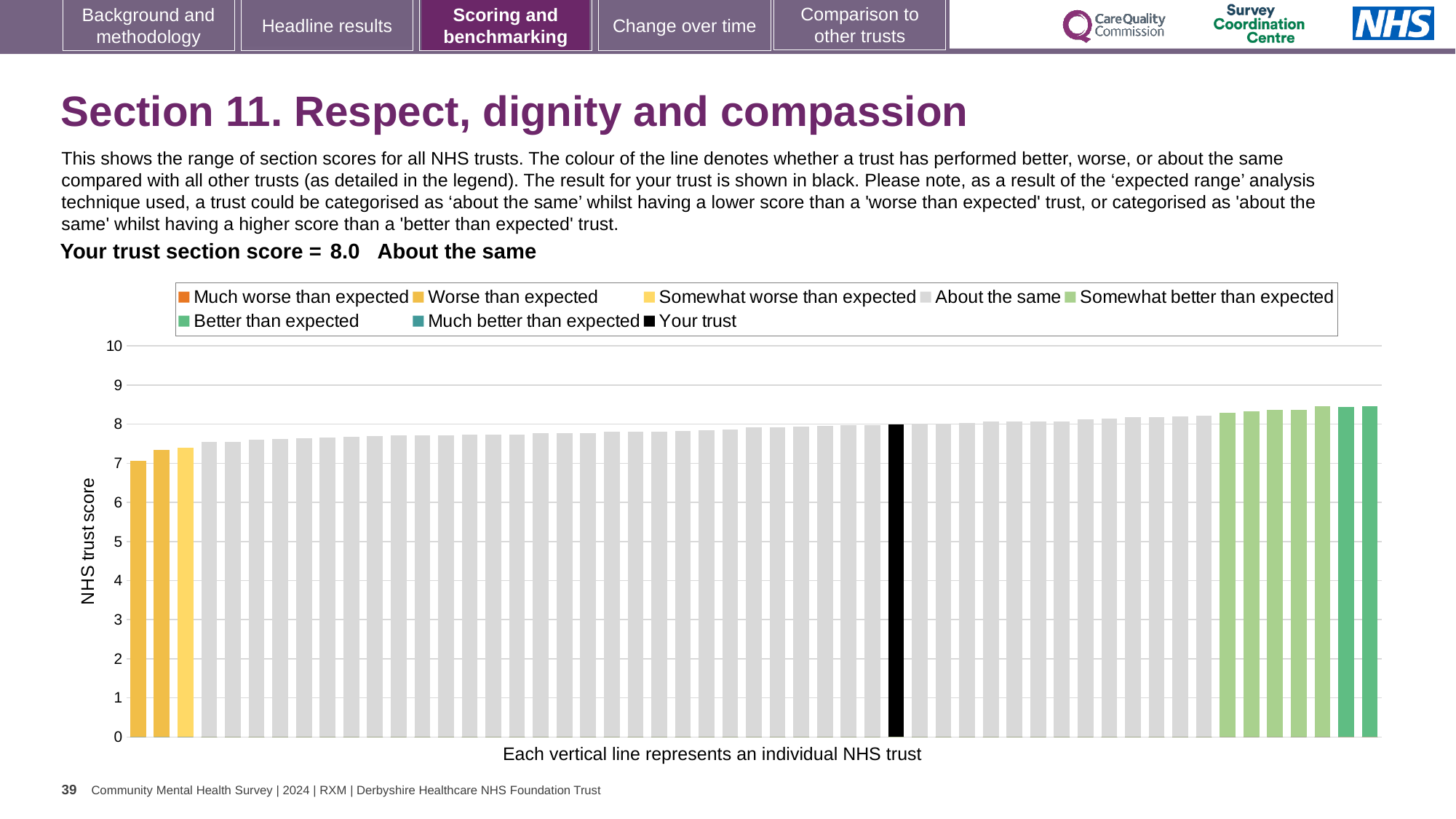
What colour is the bar representing your trust? black What is the section score for your trust shown on the slide? 8.0 Do the bar values rise or fall from left to right along the x axis? rise How many entries does the chart legend list? 8 Is the value of the tallest bar greater or less than 8? greater How is your trust's section score categorised compared with other trusts? About the same Is the value of the tallest bar greater or less than 9? less Is the value of the shortest bar greater or less than 8? less What is the label on the vertical axis of the chart? NHS trust score What kind of chart is shown on the slide? bar chart Which is larger: the value of the black bar or the value of the leftmost bar? the black bar